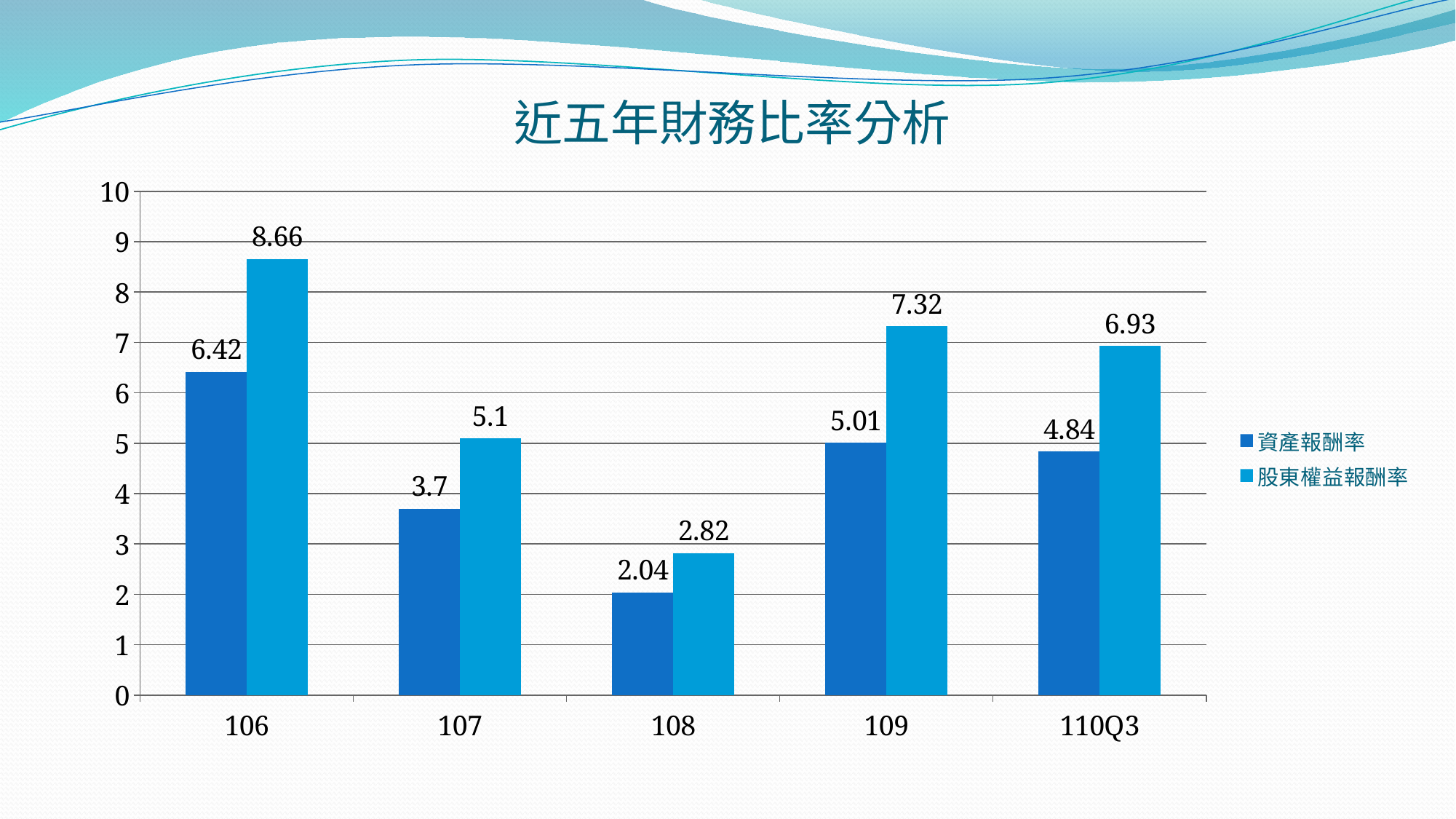
Which category has the lowest 資產報酬率? 108 What is the value of 資產報酬率 for 110Q3? 4.84 What is the difference between 股東權益報酬率 and 資產報酬率 for 107? 1.4 How many categories are shown on the x axis? 5 What is the value of 股東權益報酬率 for 109? 7.32 Which is larger: 資產報酬率 for 109 or 資產報酬率 for 110Q3? 109 What kind of chart is shown on the slide? bar chart What is the value of 資產報酬率 for 106? 6.42 Is the value of 股東權益報酬率 for 108 greater or less than 3? less Which category has the highest 股東權益報酬率? 106 What is the title of the chart? 近五年財務比率分析 How many series does the legend list? 2